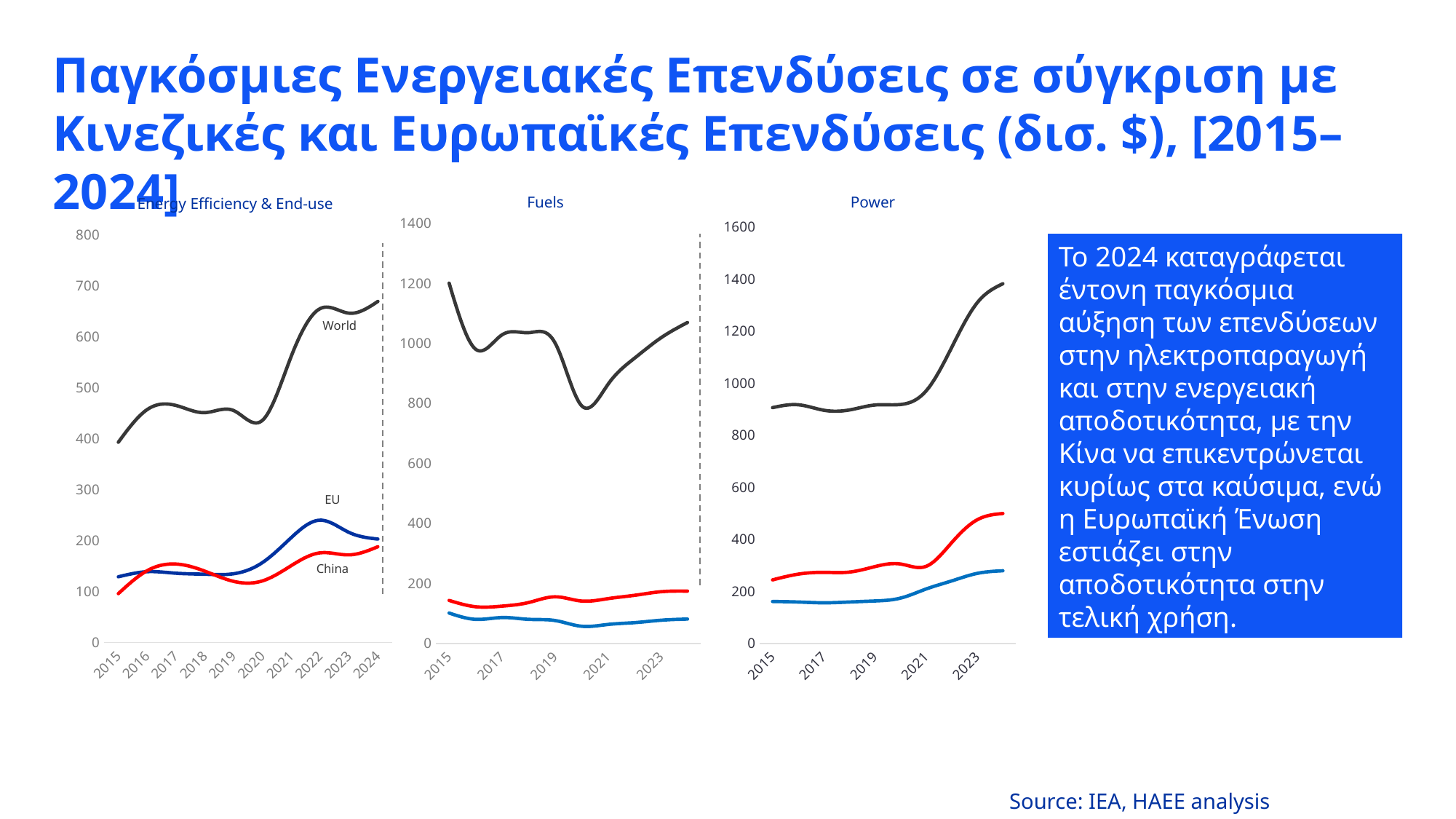
In the 'Fuels' chart, is the World value in 2020 greater or less than 1000? less How many separate chart panels are shown on the slide? 3 In the 'Fuels' chart, is the World value in 2015 greater or less than 1000? greater In the 'Energy Efficiency & End-use' chart, is the World value in 2024 greater or less than 600? greater In the 'Power' chart, does the World line rise or fall from 2019 to 2024? rises In the 'Energy Efficiency & End-use' chart, which is higher in 2022, EU or China? EU In the 'Power' chart, which is higher in 2024, the red (China) line or the blue (EU) line? China (red) Which of the three charts has the highest maximum value on its y axis? Power What kind of chart is used in the 'Fuels' panel? Line chart